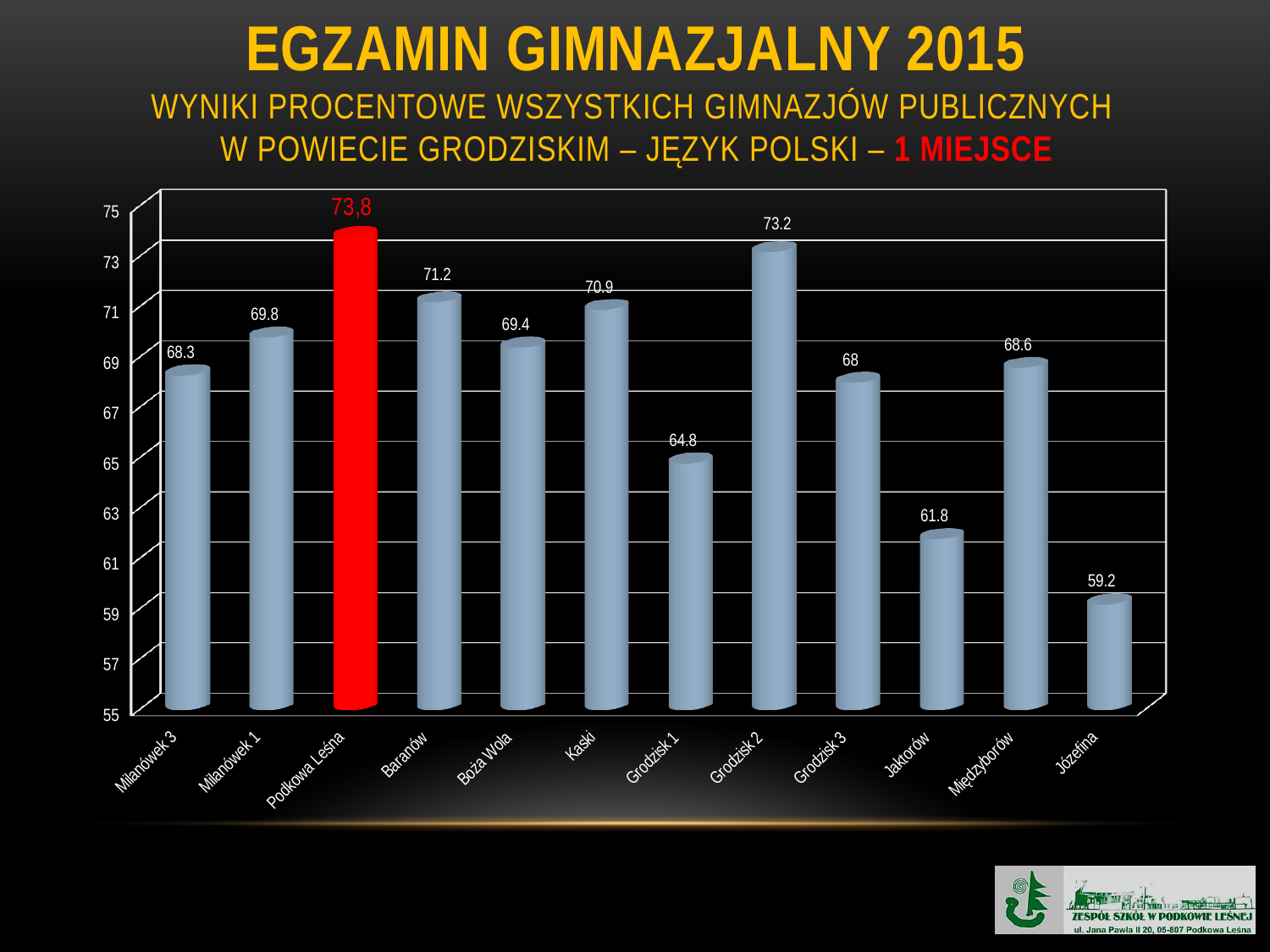
What is the value for Grodzisk 2? 73.2 What is the difference between the values for Milanówek 1 and Milanówek 3? 1.5 Which is larger, the value for Grodzisk 1 or the value for Jaktorów? Grodzisk 1 Which school has the highest value? Podkowa Leśna What is the difference between the values for Podkowa Leśna and Grodzisk 2? 0.6 What is the value for Podkowa Leśna? 73,8 How many schools are shown on the chart? 12 What kind of chart is shown on the slide? bar chart Is the value for Józefina greater or less than 61? less Which school has the lowest value? Józefina What is the value for Grodzisk 3? 68 What is the value for Jaktorów? 61.8